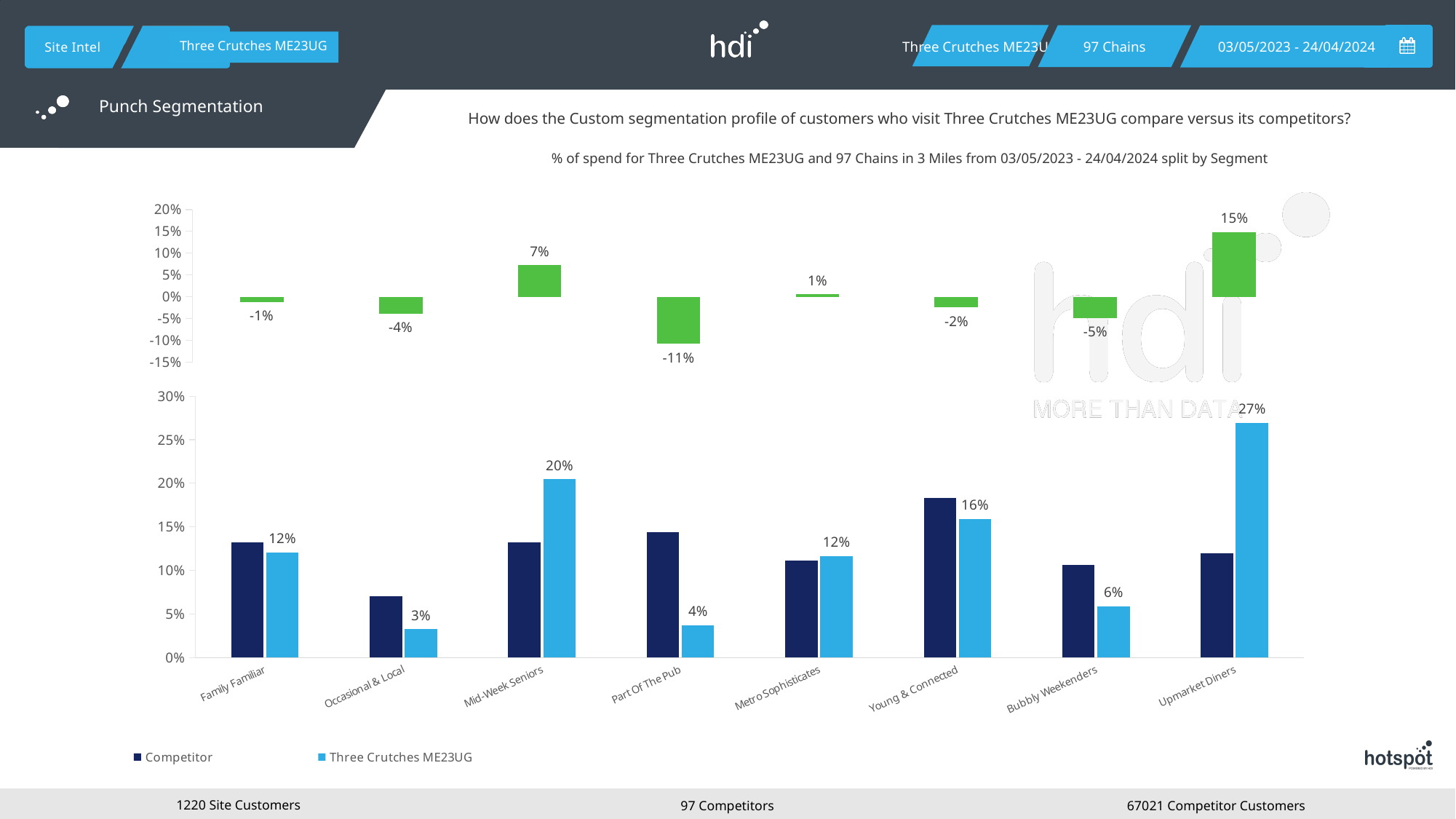
In the bottom chart, which segment has the highest value for Three Crutches ME23UG? Upmarket Diners In the bottom chart, what is the value for Three Crutches ME23UG in the Mid-Week Seniors segment? 20% In the bottom chart, is the Competitor value for Young & Connected greater or less than 15%? greater In the bottom chart, how many segments are shown on the x axis? 8 In the bottom chart, which segment has the lowest value for Three Crutches ME23UG? Occasional & Local In the top chart, which segment has the highest value? Upmarket Diners In the top chart, what is the value shown for Part Of The Pub? -11% In the bottom chart, what is the value for Three Crutches ME23UG in the Upmarket Diners segment? 27% In the bottom chart, what is the difference between the Three Crutches ME23UG values for Upmarket Diners and Bubbly Weekenders? 21% How many series does the legend of the bottom chart list? 2 In the bottom chart, for the Part Of The Pub segment, which is larger: the Competitor bar or the Three Crutches ME23UG bar? Competitor What kind of chart is the bottom chart? Bar chart